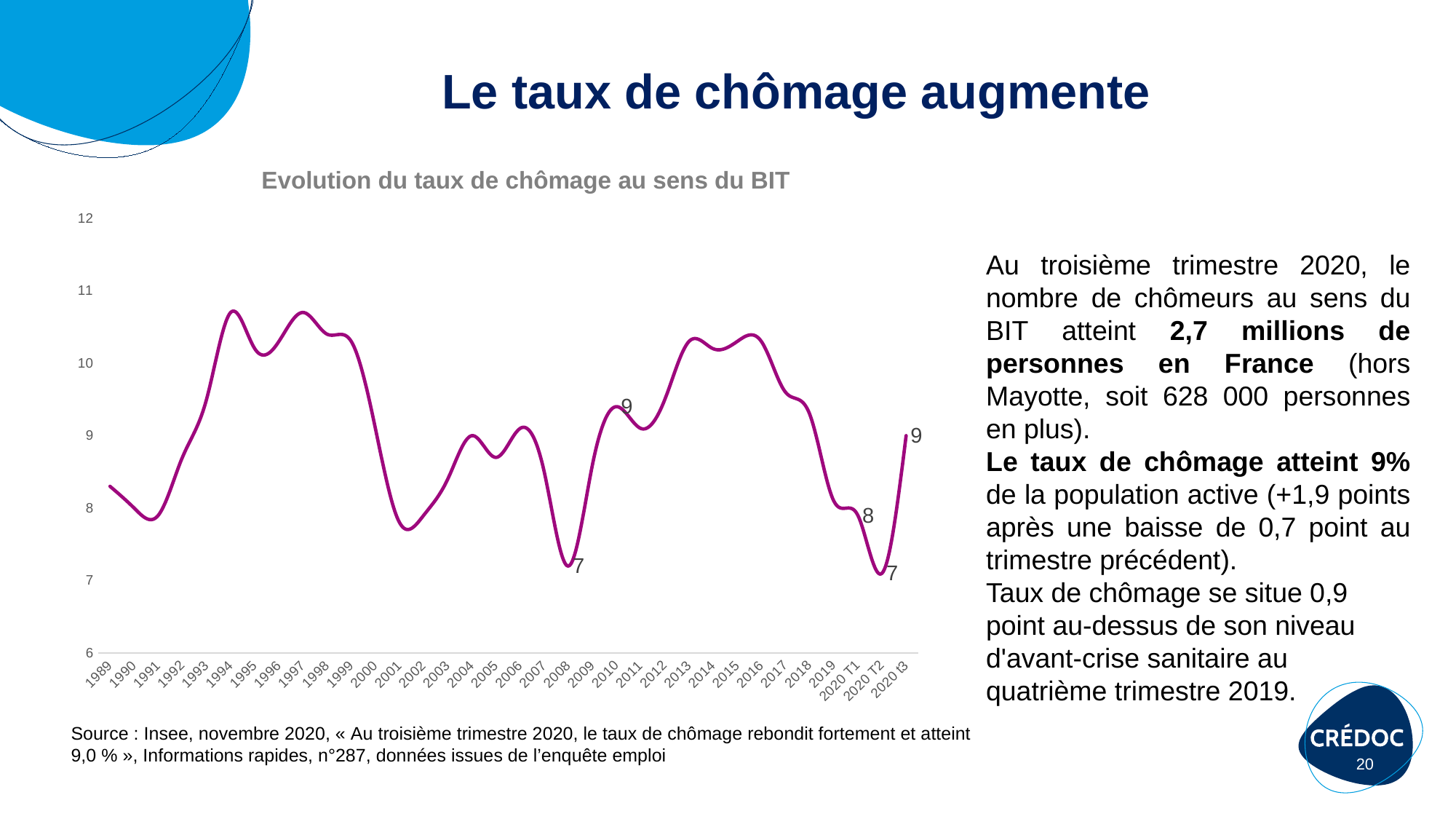
What is the value shown for 2020 T2? 7 What is the title of the chart? Evolution du taux de chômage au sens du BIT What is the value shown for 2020 t3? 9 What is the value labelled at 2010? 9 What kind of chart is shown on the slide? line chart Which is larger, the value for 1994 or the value for 2001? 1994 What is the value labelled at 2008? 7 What is the value shown for 2020 T1? 8 What is the difference between the value for 2020 t3 and the value for 2020 T2? 2 Is the value for 2001 greater or less than 8? less Does the line rise or fall between 2020 T2 and 2020 t3? rises Is the value for 1994 greater or less than 10? greater